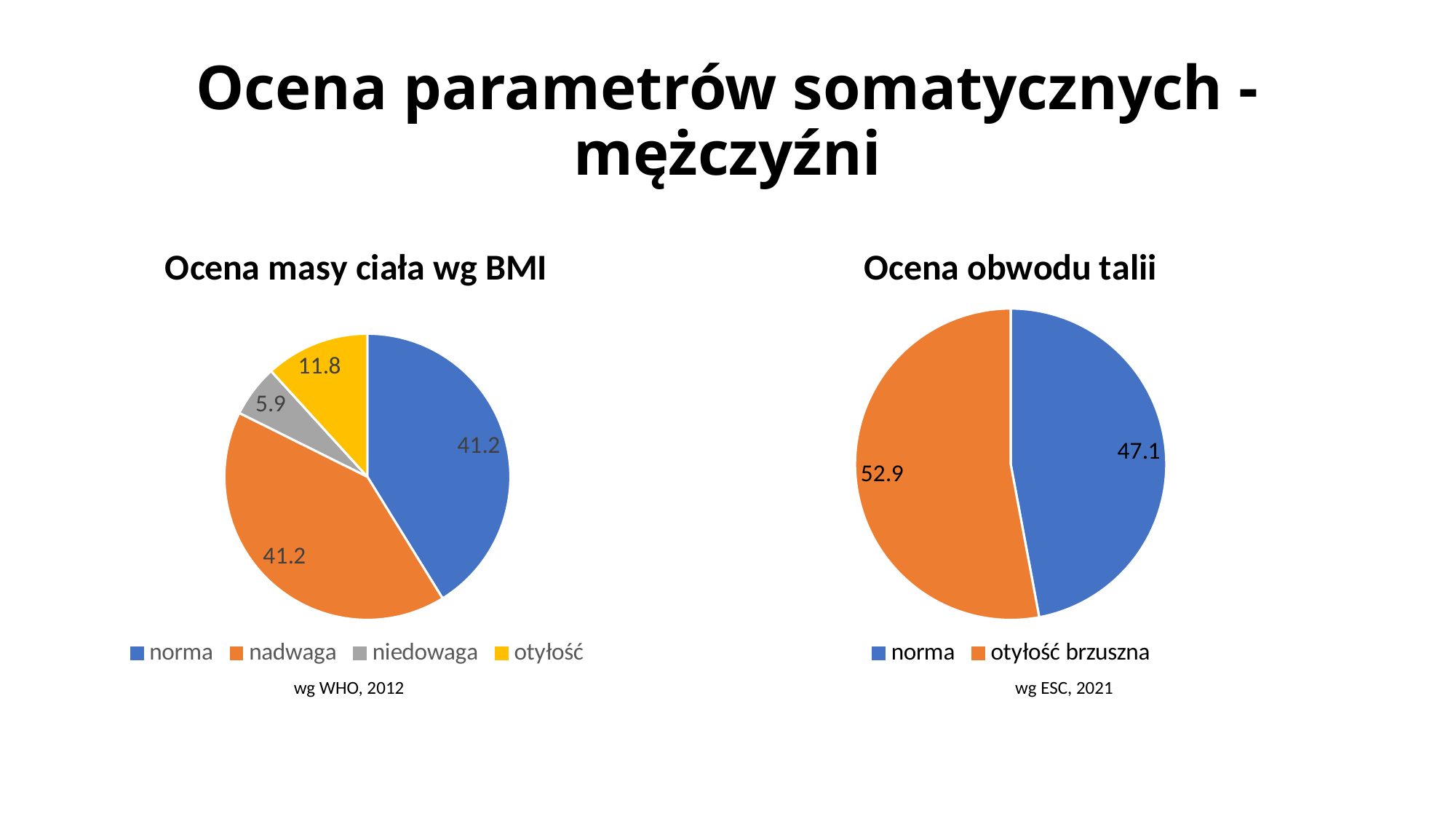
In the 'Ocena obwodu talii' chart, which category has the highest value? otyłość brzuszna What type of chart is the 'Ocena obwodu talii' chart? pie chart In the 'Ocena masy ciała wg BMI' chart, which is larger, the value for otyłość or the value for niedowaga? otyłość In the 'Ocena masy ciała wg BMI' chart, what is the value for niedowaga? 5.9 In the 'Ocena masy ciała wg BMI' chart, what is the value for nadwaga? 41.2 In the 'Ocena obwodu talii' chart, what is the difference between the values for otyłość brzuszna and norma? 5.8 In the 'Ocena obwodu talii' chart, what is the value for otyłość brzuszna? 52.9 In the 'Ocena masy ciała wg BMI' chart, what is the value for otyłość? 11.8 How many categories does the 'Ocena masy ciała wg BMI' chart show? 4 In the 'Ocena masy ciała wg BMI' chart, what is the difference between the values for otyłość and niedowaga? 5.9 In the 'Ocena obwodu talii' chart, what is the value for norma? 47.1 In the 'Ocena masy ciała wg BMI' chart, which category has the lowest value? niedowaga